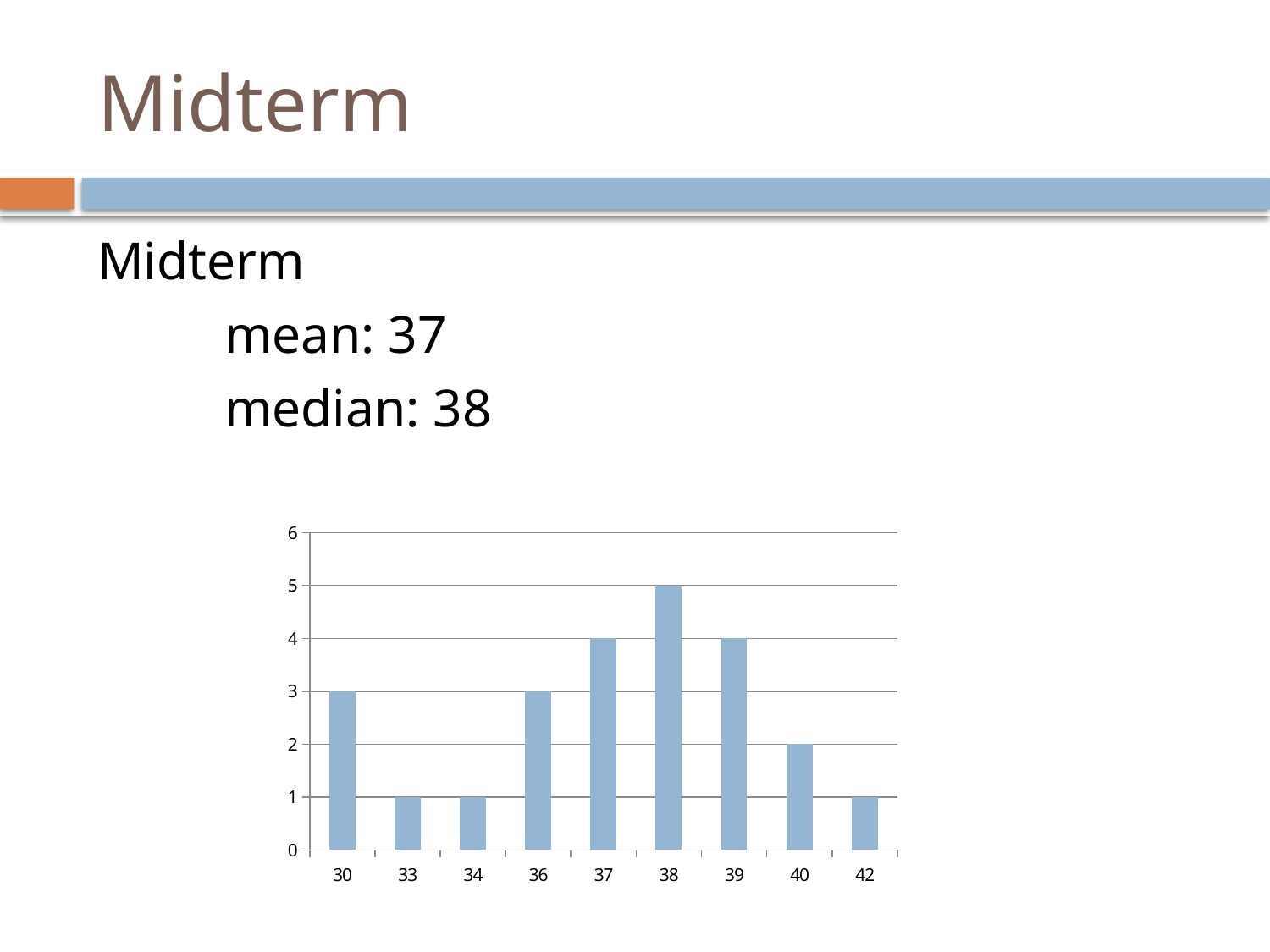
How many categories are shown on the x axis of the chart? 9 Do the values for categories 37 and 39 have the same height? yes What is the difference between the values for category 38 and category 40? 3 Which category has the highest bar? 38 Is the value for category 39 greater or less than 3? greater What is the value of the bar for category 30? 3 What is the value of the bar for category 40? 2 What type of chart is shown on the slide? bar chart What is the highest value shown on the y axis of the chart? 6 Which is larger, the value for category 37 or the value for category 33? 37 Which category has the lowest bar, 36 or 42? 42 What is the value of the bar for category 38? 5